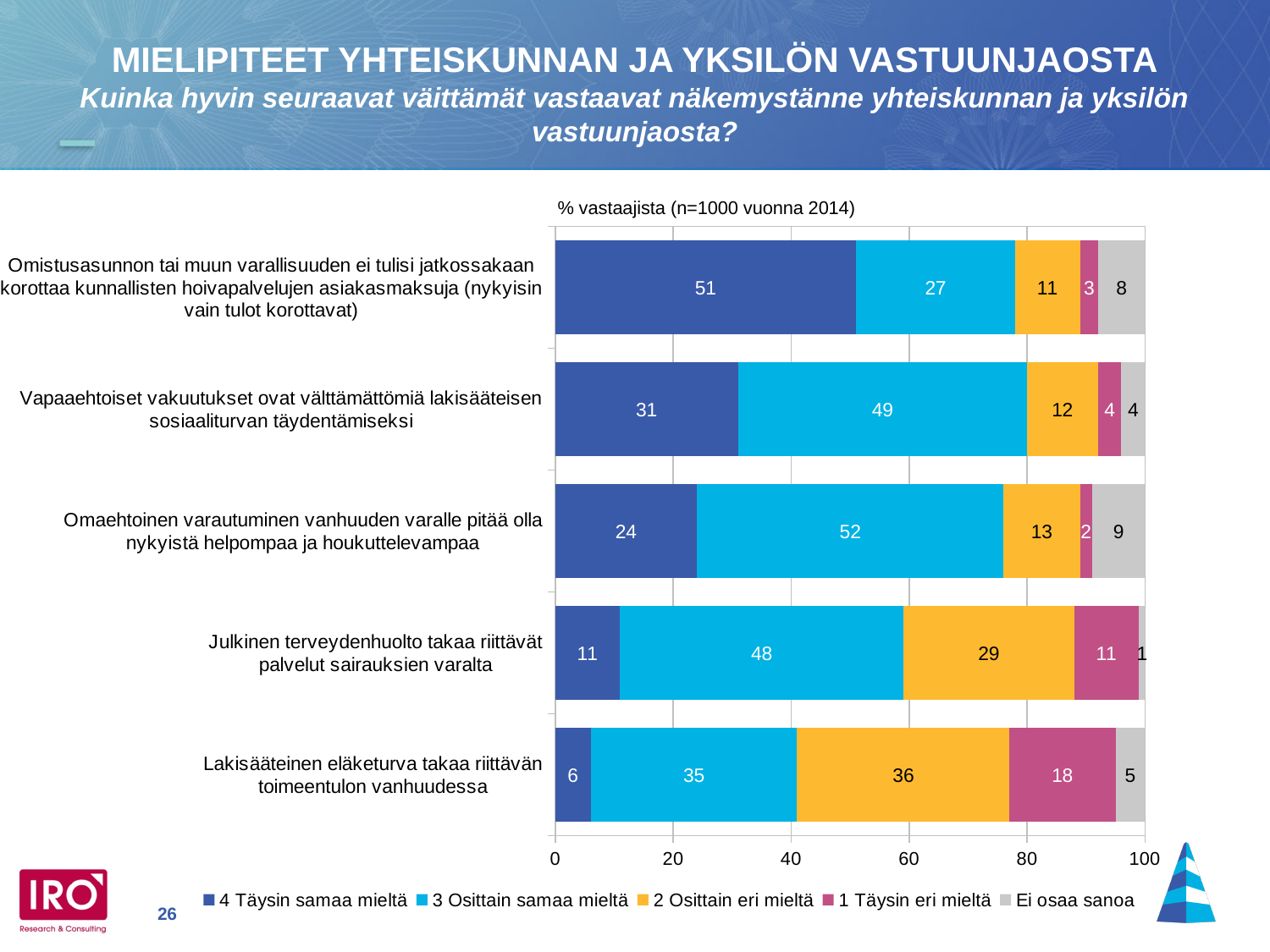
Which statement has the highest "4 Täysin samaa mieltä" share? Omistusasunnon tai muun varallisuuden ei tulisi jatkossakaan korottaa kunnallisten hoivapalvelujen asiakasmaksuja What is the difference between the "2 Osittain eri mieltä" values for "Lakisääteinen eläketurva takaa riittävän toimeentulon vanhuudessa" and "Omistusasunnon tai muun varallisuuden ei tulisi jatkossakaan korottaa kunnallisten hoivapalvelujen asiakasmaksuja"? 25 What is the "3 Osittain samaa mieltä" value for "Omaehtoinen varautuminen vanhuuden varalle pitää olla nykyistä helpompaa ja houkuttelevampaa"? 52 What kind of chart is shown on the slide? Stacked bar chart Which statement has the lowest "4 Täysin samaa mieltä" share? Lakisääteinen eläketurva takaa riittävän toimeentulon vanhuudessa What is the total of the stacked bar for "Vapaaehtoiset vakuutukset ovat välttämättömiä lakisääteisen sosiaaliturvan täydentämiseksi"? 100 Which is larger: the "3 Osittain samaa mieltä" value for "Vapaaehtoiset vakuutukset ovat välttämättömiä lakisääteisen sosiaaliturvan täydentämiseksi" or for "Julkinen terveydenhuolto takaa riittävät palvelut sairauksien varalta"? Vapaaehtoiset vakuutukset ovat välttämättömiä lakisääteisen sosiaaliturvan täydentämiseksi What is the "2 Osittain eri mieltä" value for "Julkinen terveydenhuolto takaa riittävät palvelut sairauksien varalta"? 29 How many statements (categories) are shown in the chart? 5 What percentage of respondents answered "4 Täysin samaa mieltä" to the statement "Omistusasunnon tai muun varallisuuden ei tulisi jatkossakaan korottaa kunnallisten hoivapalvelujen asiakasmaksuja"? 51 How many series does the legend list? 5 What is the "1 Täysin eri mieltä" value for "Lakisääteinen eläketurva takaa riittävän toimeentulon vanhuudessa"? 18